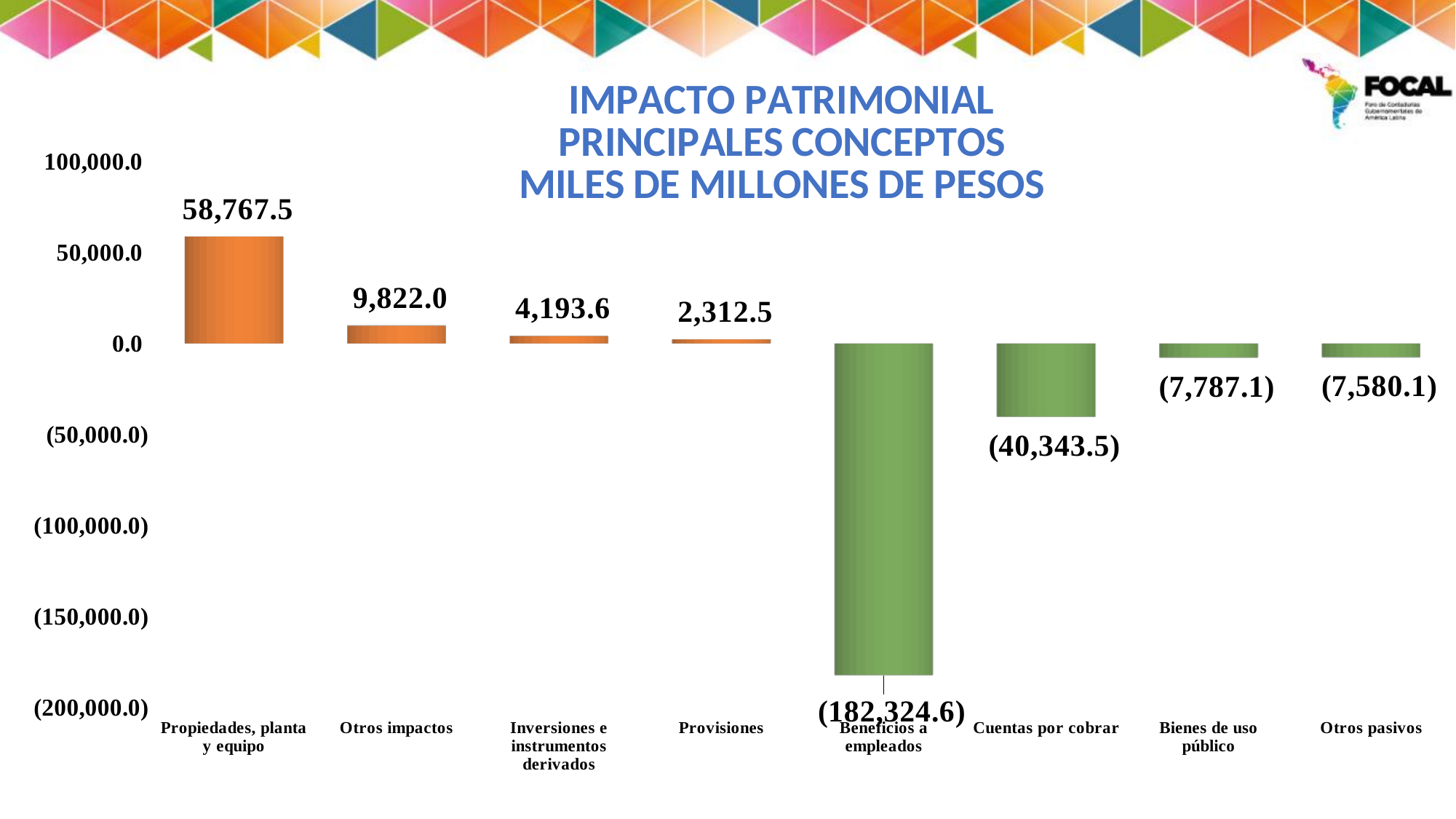
What is the value for Provisiones? 2,312.5 What is the value for Cuentas por cobrar? (40,343.5) What kind of chart is shown on the slide? Bar chart Which category has the highest value? Propiedades, planta y equipo What is the value for Propiedades, planta y equipo? 58,767.5 What is the title of the chart? IMPACTO PATRIMONIAL PRINCIPALES CONCEPTOS MILES DE MILLONES DE PESOS Which category has the lowest value? Beneficios a empleados What is the difference between the values for Propiedades, planta y equipo and Otros impactos? 48,945.5 What is the value for Otros pasivos? (7,580.1) Which is larger, the value for Otros impactos or the value for Inversiones e instrumentos derivados? Otros impactos How many categories are shown on the x axis? 8 What is the value for Beneficios a empleados? (182,324.6)